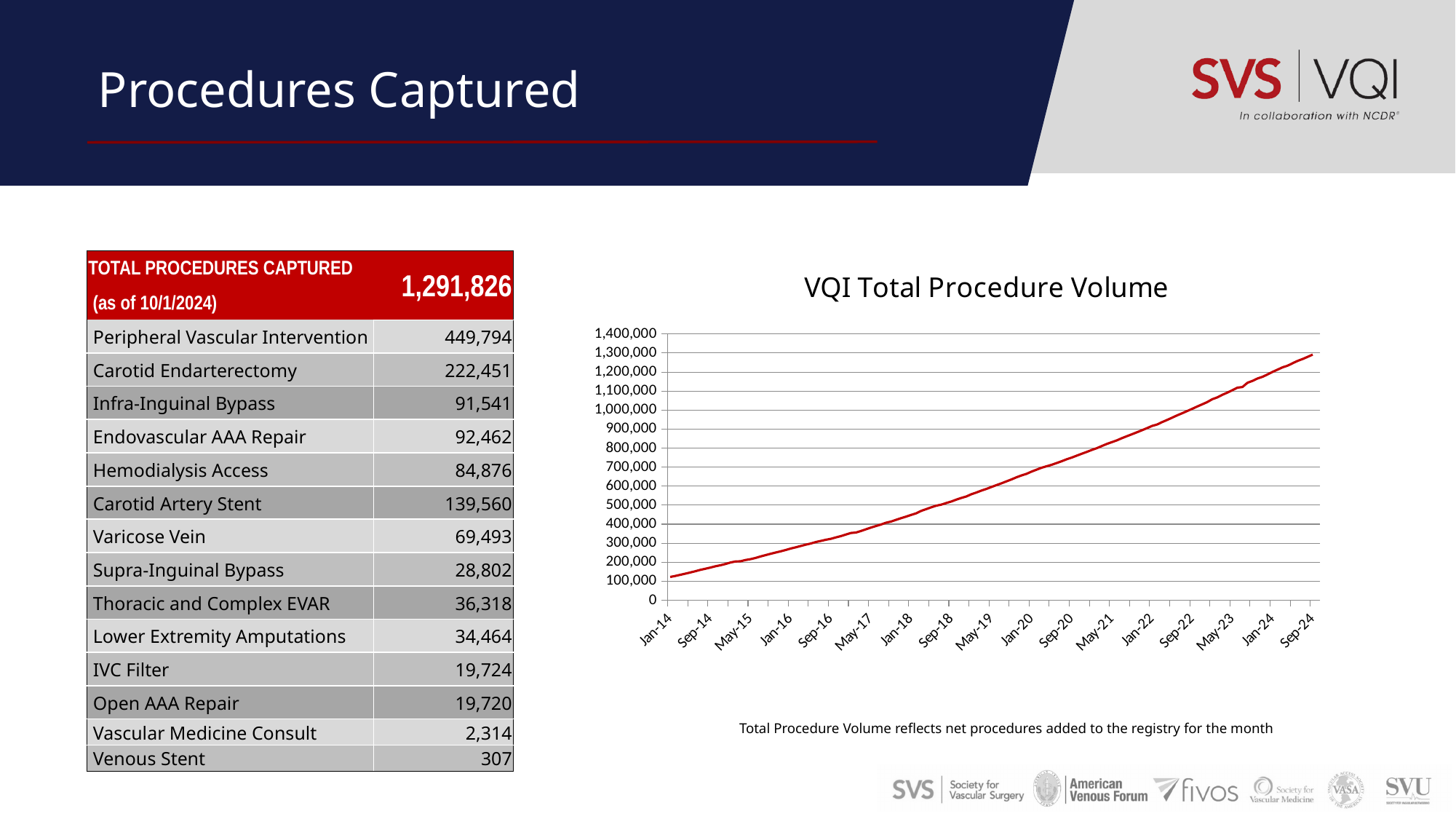
Does the VQI Total Procedure Volume line rise or fall from Jan-14 to Sep-24? rise Is the value for Jan-14 greater or less than 200,000? less At which x-axis label does the VQI Total Procedure Volume line reach its highest value? Sep-24 Is the value for Sep-16 greater or less than 400,000? less Is the value for Sep-24 greater or less than 1,200,000? greater At which x-axis label is the VQI Total Procedure Volume line at its lowest value? Jan-14 How many labels are shown on the x axis of the chart? 17 What is the highest value shown on the y axis of the chart? 1,400,000 What is the title of the chart on the slide? VQI Total Procedure Volume Which is larger, the value for Sep-20 or the value for Sep-16? Sep-20 What kind of chart is shown on the slide? line chart